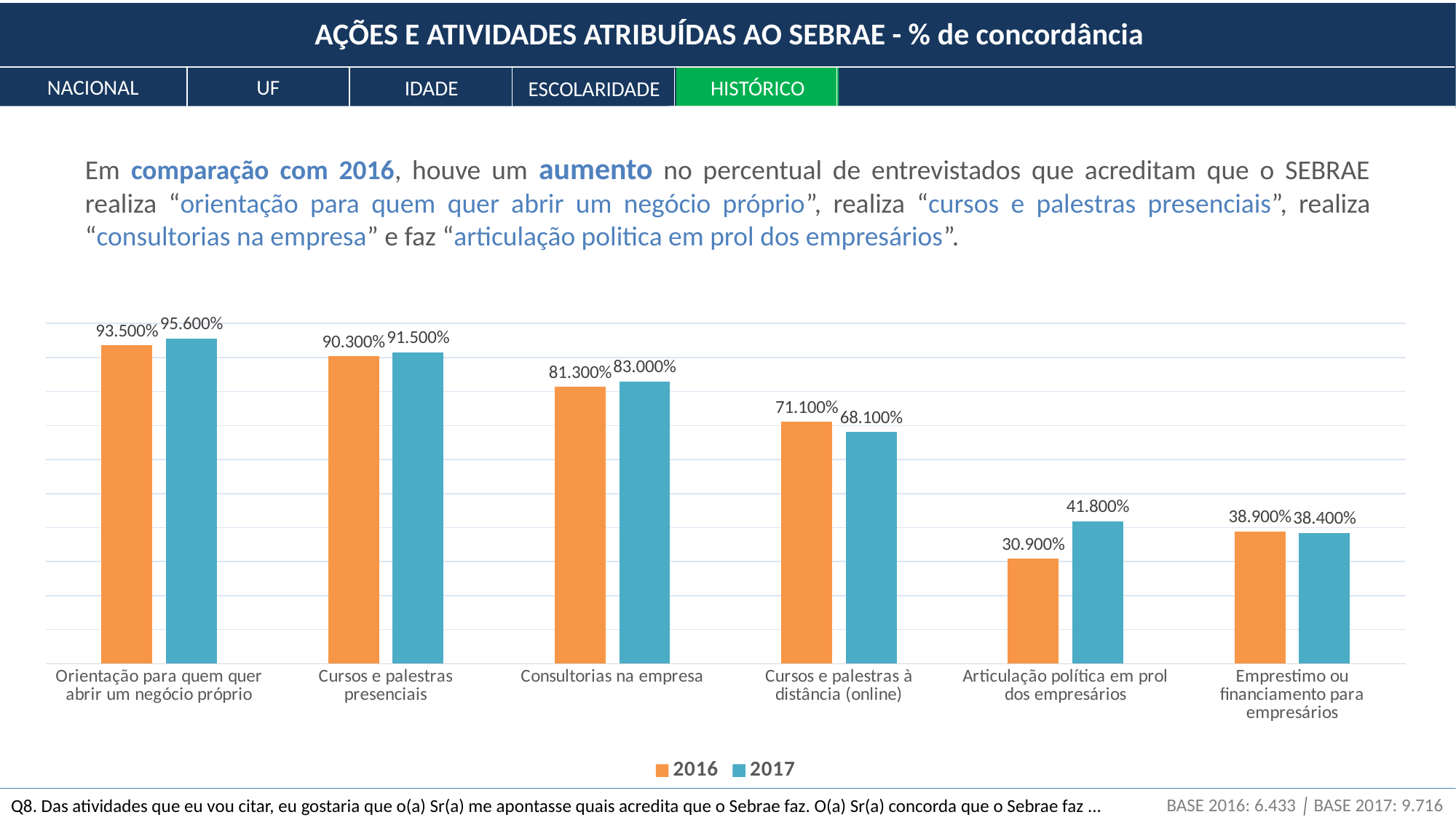
What is the difference between the 2017 and 2016 values for "Articulação política em prol dos empresários"? 10.900% How many categories are shown on the x axis of the chart? 6 What kind of chart is shown on the slide? Bar chart Which category has the lowest 2016 value? Articulação política em prol dos empresários What is the 2017 value for "Cursos e palestras à distância (online)"? 68.100% For "Emprestimo ou financiamento para empresários", which year has the larger value, 2016 or 2017? 2016 What is the difference between the 2016 and 2017 values for "Cursos e palestras à distância (online)"? 3.000% Which category has the highest 2017 value? Orientação para quem quer abrir um negócio próprio How many series does the chart legend list? 2 What is the 2016 value for "Articulação política em prol dos empresários"? 30.900% What is the 2017 value for "Consultorias na empresa"? 83.000% For "Cursos e palestras presenciais", which year has the larger value, 2016 or 2017? 2017